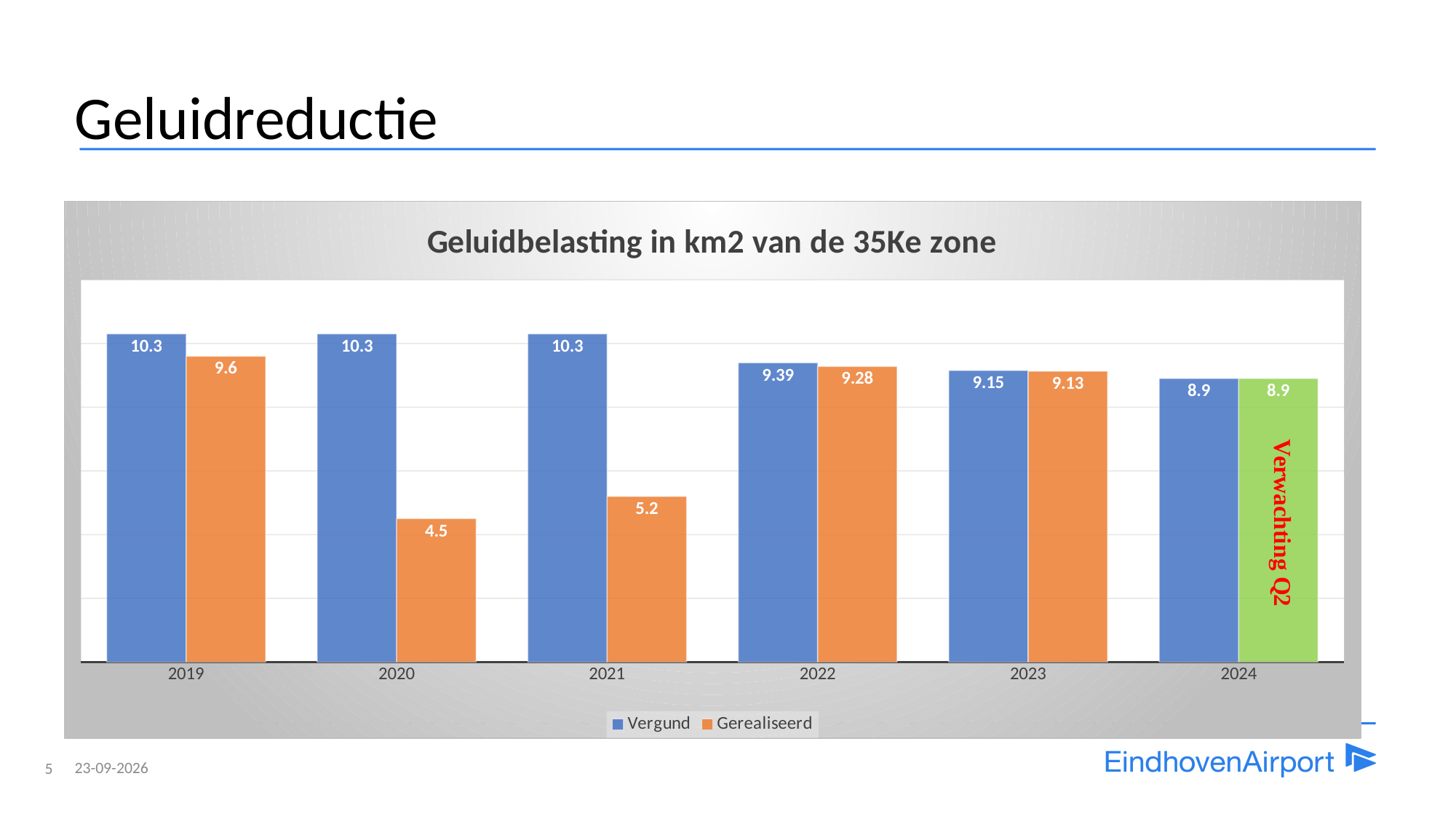
Which year has the lowest Gerealiseerd value? 2020 Which year has the lowest Vergund value? 2024 What is the Gerealiseerd value for 2020? 4.5 What is the difference between the Vergund and Gerealiseerd values for 2021? 5.1 What is the difference between the Gerealiseerd values for 2019 and 2020? 5.1 What is the Vergund value for 2024? 8.9 How many years are shown on the x axis? 6 How many series does the legend list? 2 What is the Vergund value for 2022? 9.39 What kind of chart is shown on the slide? Bar chart What is the Gerealiseerd value for 2023? 9.13 Which is larger, the Gerealiseerd value for 2019 or for 2021? 2019